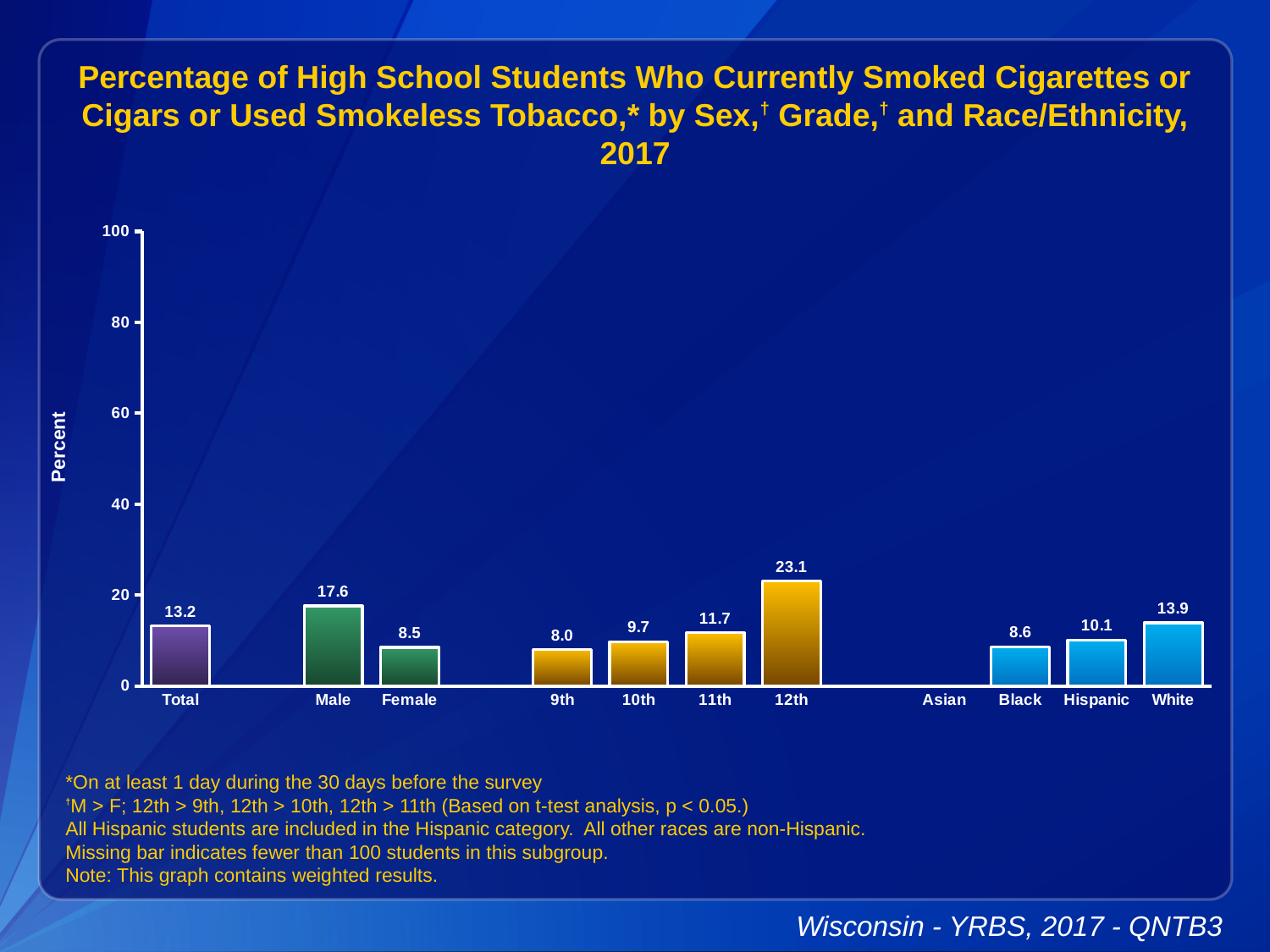
Do the values rise or fall from 9th grade to 12th grade? rise Which category with a bar has the lowest value? 9th What is the value for Male? 17.6 Which category has no bar shown? Asian What is the value for Hispanic? 10.1 What is the value for Total? 13.2 What is the difference between the Male and Female values? 9.1 What kind of chart is shown? bar chart What is the value for 12th grade? 23.1 Which category has the highest value? 12th Is the value for 12th grade greater or less than 20? greater Which is larger, the value for Black or the value for White? White